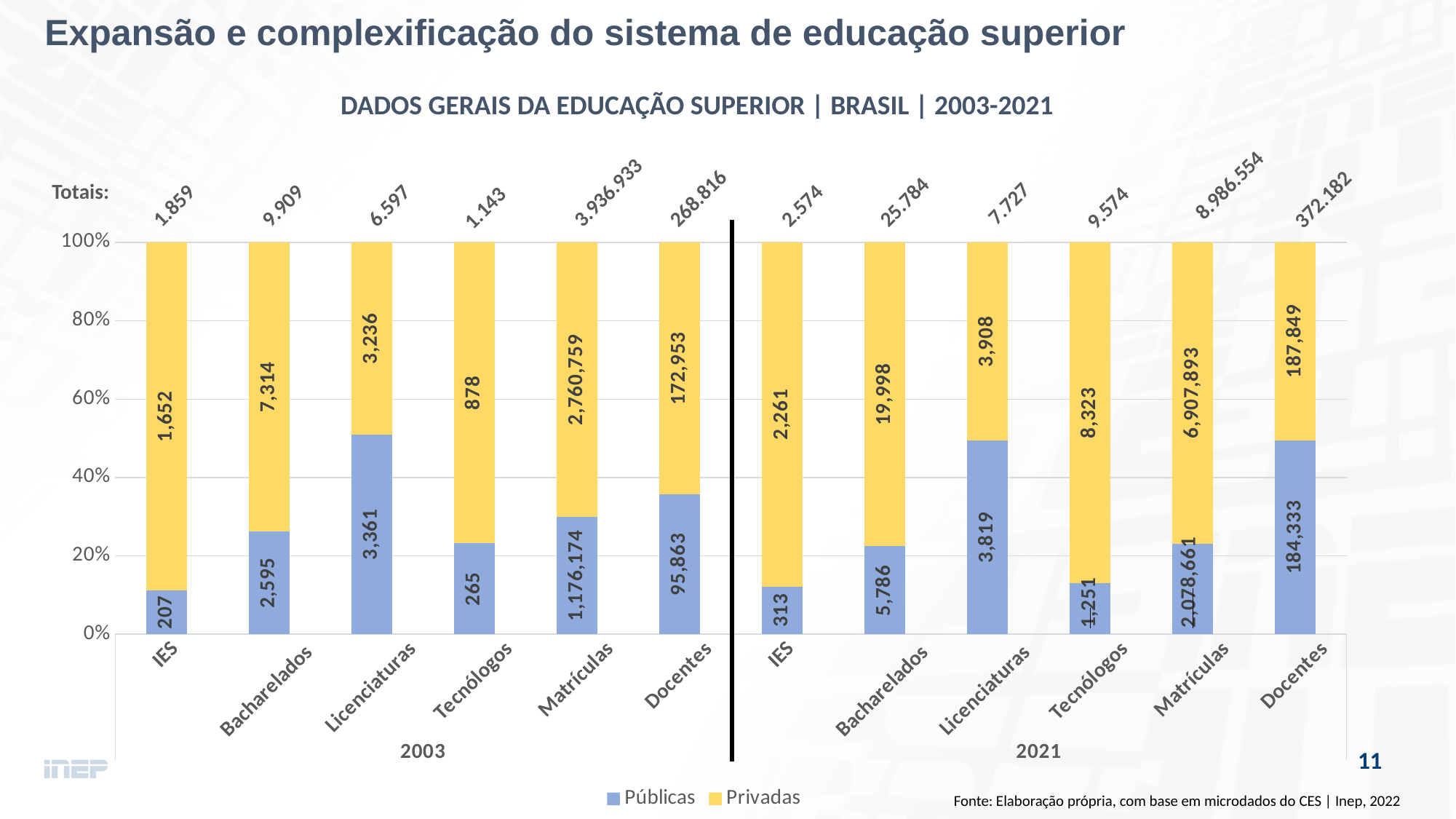
How many stacked bars are plotted in the chart in total? 12 What is the difference between the Privadas and Públicas values in the Docentes bar for 2021? 3,516 What kind of chart is shown on the slide? Stacked bar chart What is the value for Públicas in the IES bar for 2003? 207 What total is printed above the Matrículas bar for 2021? 8.986.554 Is the Públicas share of the Licenciaturas bar for 2021 greater or less than 40%? greater How many series does the legend list? 2 What is the difference between the Privadas and Públicas values in the Licenciaturas bar for 2021? 89 What is the value for Públicas in the Matrículas bar for 2021? 2,078,661 Is the Públicas share of the IES bar for 2003 greater or less than 20%? less What is the value for Privadas in the Docentes bar for 2021? 187,849 In the Licenciaturas bar for 2003, which is larger, the Públicas value or the Privadas value? Públicas